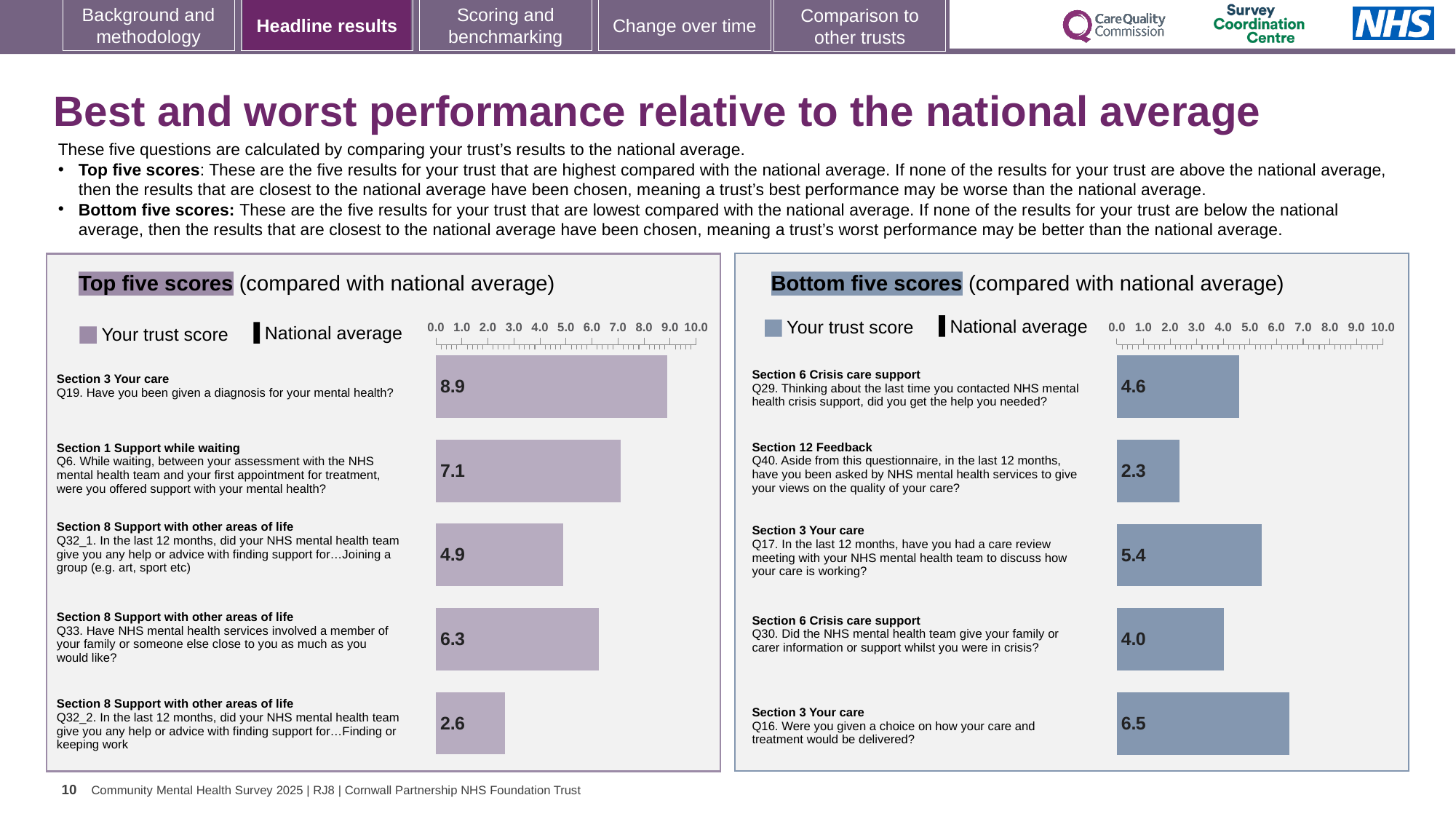
What kind of chart is the Bottom five scores chart? Bar chart In the Bottom five scores chart, which question has the highest trust score? Q16 In the Top five scores chart, what is the trust score for Q19 (Have you been given a diagnosis for your mental health?)? 8.9 How many entries does the legend of the Top five scores chart list? 2 In the Bottom five scores chart, what is the trust score for Q40 (asked by NHS mental health services to give your views on the quality of your care)? 2.3 How many bars are plotted in the Top five scores chart? 5 In the Bottom five scores chart, which has the larger trust score, Q17 or Q30? Q17 In the Bottom five scores chart, what is the difference between the trust scores for Q16 and Q29? 1.9 In the Top five scores chart, which question has the highest trust score? Q19 In the Top five scores chart, what is the difference between the trust scores for Q19 and Q6? 1.8 In the Top five scores chart, which question has the lowest trust score? Q32_2 In the Bottom five scores chart, which question has the lowest trust score? Q40